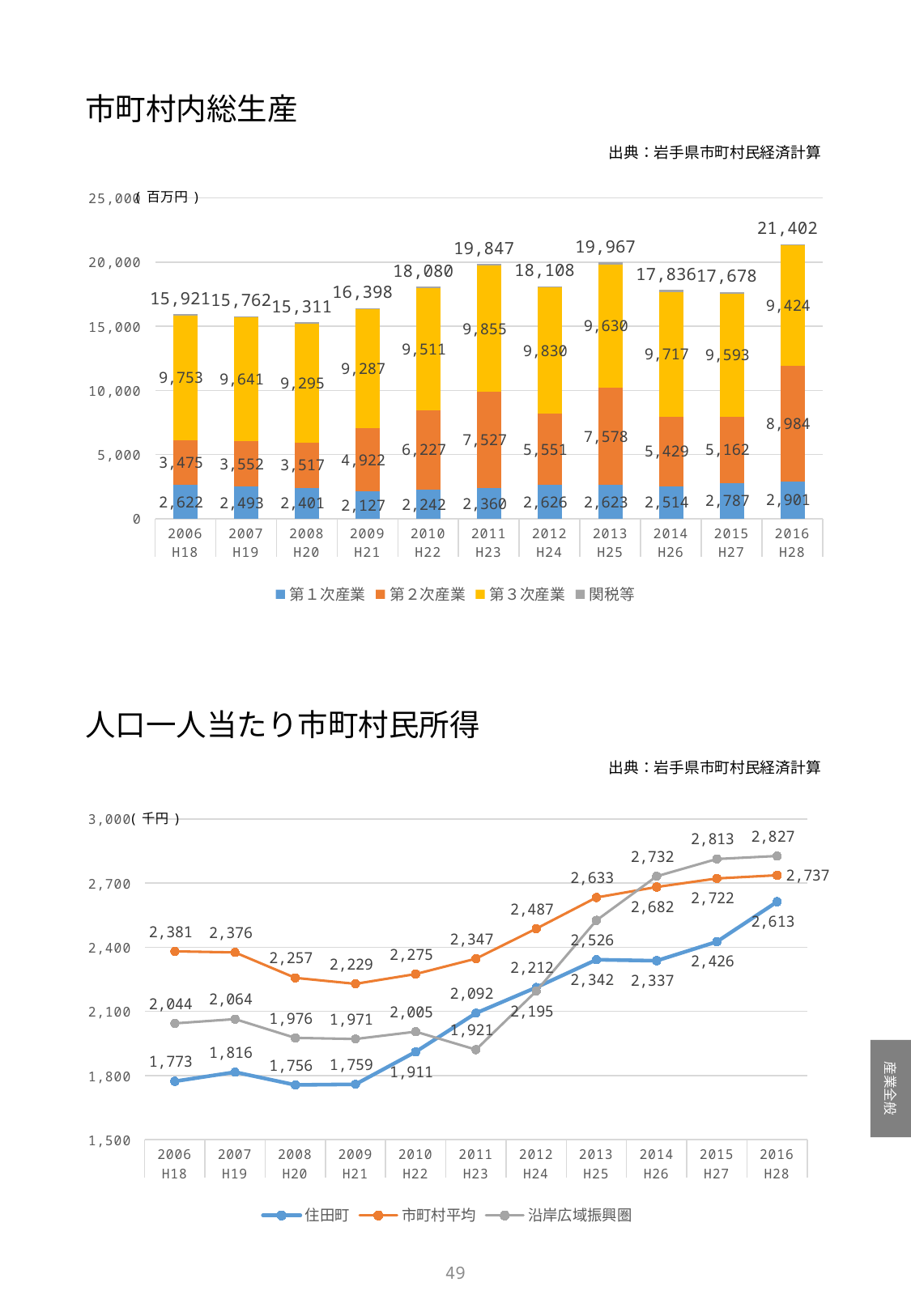
In the 人口一人当たり市町村民所得 chart, does the 住田町 line generally rise or fall from 2009 (H21) to 2016 (H28)? Rise In the 市町村内総生産 chart, which year has the lowest total value? 2008 (H20) In the 市町村内総生産 chart, what is the value of 第２次産業 in 2011 (H23)? 7,527 In the 人口一人当たり市町村民所得 chart, which series has the highest value in 2016 (H28)? 沿岸広域振興圏 In the 市町村内総生産 chart, which is larger: 第１次産業 in 2015 (H27) or 第１次産業 in 2009 (H21)? 2015 (H27) In the 人口一人当たり市町村民所得 chart, how many years are plotted on the x axis? 11 In the 人口一人当たり市町村民所得 chart, what is the difference between 市町村平均 and 住田町 in 2006 (H18)? 608 In the 市町村内総生産 chart, what is the difference between the 第３次産業 values for 2011 (H23) and 2016 (H28)? 431 In the 人口一人当たり市町村民所得 chart, what is the value for 住田町 in 2010 (H22)? 1,911 What kind of chart is the 市町村内総生産 chart? Stacked bar chart In the 市町村内総生産 chart, how many series does the legend list? 4 In the 市町村内総生産 chart, what is the total value labeled above the bar for 2016 (H28)? 21,402